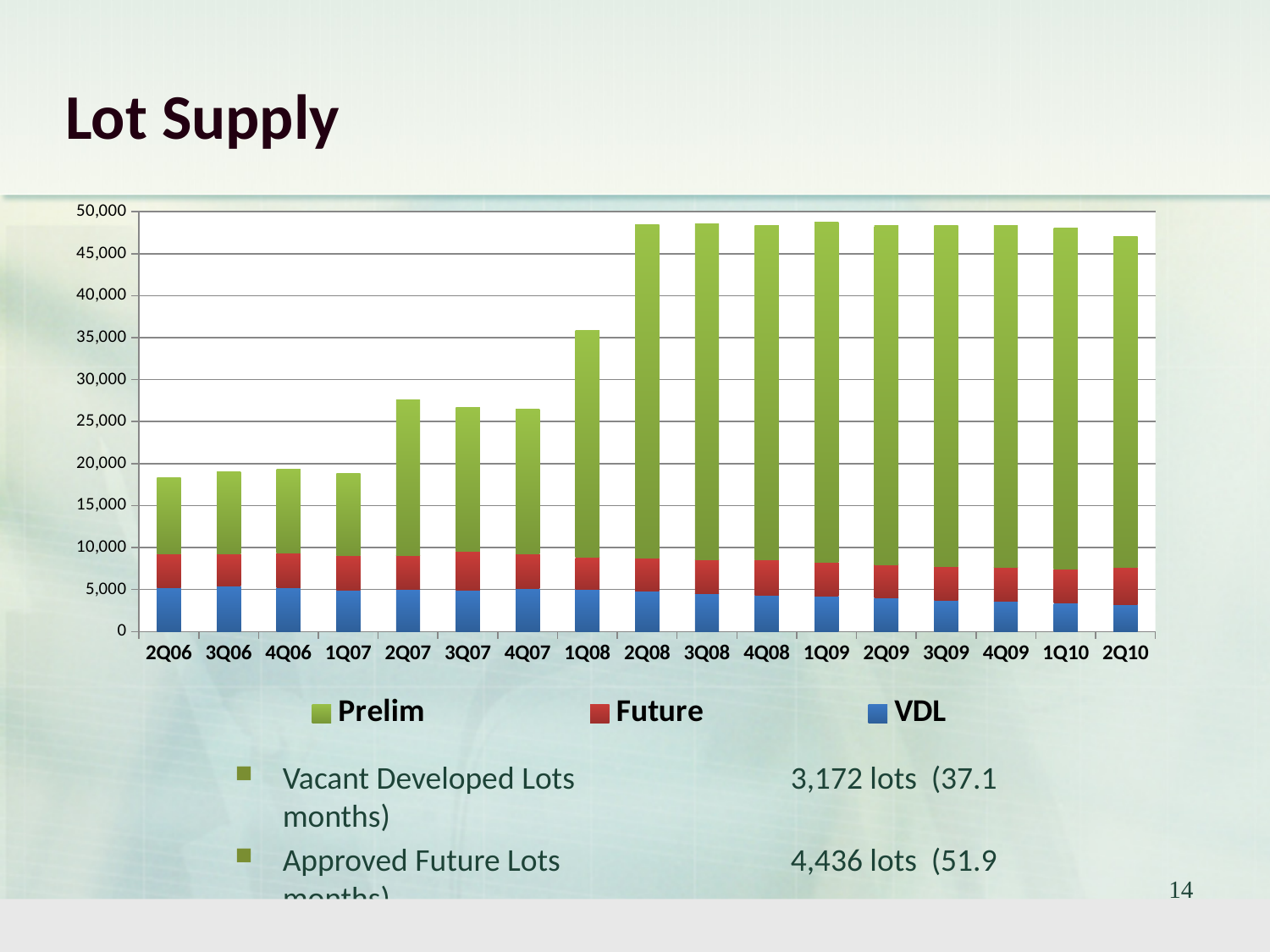
Is the total bar height for 2Q08 greater or less than 45,000? greater Is the total bar height for 1Q08 greater or less than 30,000? greater Does the VDL segment generally rise or fall from 2Q06 to 2Q10? fall Is the total bar height for 2Q06 greater or less than 20,000? less What kind of chart is shown on the slide? stacked bar chart Which has the larger VDL segment, 2Q06 or 2Q10? 2Q06 What is the title of the slide containing the chart? Lot Supply Which series is shown in green in the chart? Prelim Which has the larger total bar, 1Q08 or 2Q08? 2Q08 How many series does the chart's legend list? 3 How many quarters are shown along the x axis of the chart? 17